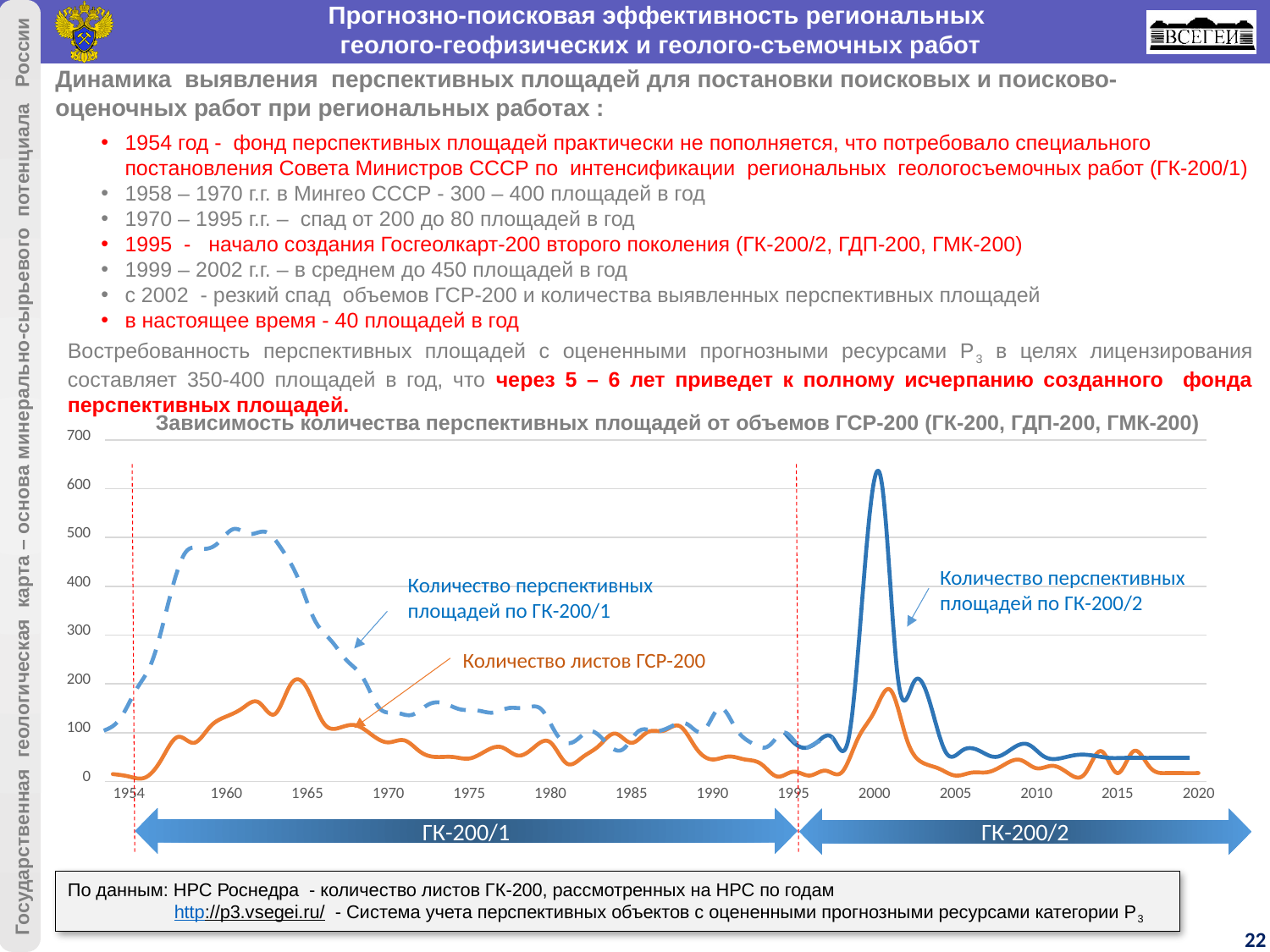
Is the value of 'Количество перспективных площадей по ГК-200/2' in 2020 greater or less than 100? less What kind of chart is shown on the slide? line chart Around the year 2000, which is larger: the value of 'Количество перспективных площадей по ГК-200/2' or the value of 'Количество листов ГСР-200'? Количество перспективных площадей по ГК-200/2 How many data series are plotted on the chart? 3 Does the series 'Количество перспективных площадей по ГК-200/1' rise or fall between 1965 and 1970? fall Is the value of 'Количество листов ГСР-200' in 1954 greater or less than 100? less Which series reaches the highest value on the chart? Количество перспективных площадей по ГК-200/2 Is the peak value of the series 'Количество перспективных площадей по ГК-200/2' around the year 2000 greater or less than 600? greater Which series is drawn as a dashed line? Количество перспективных площадей по ГК-200/1 What is the title of the chart? Зависимость количества перспективных площадей от объемов ГСР-200 (ГК-200, ГДП-200, ГМК-200)